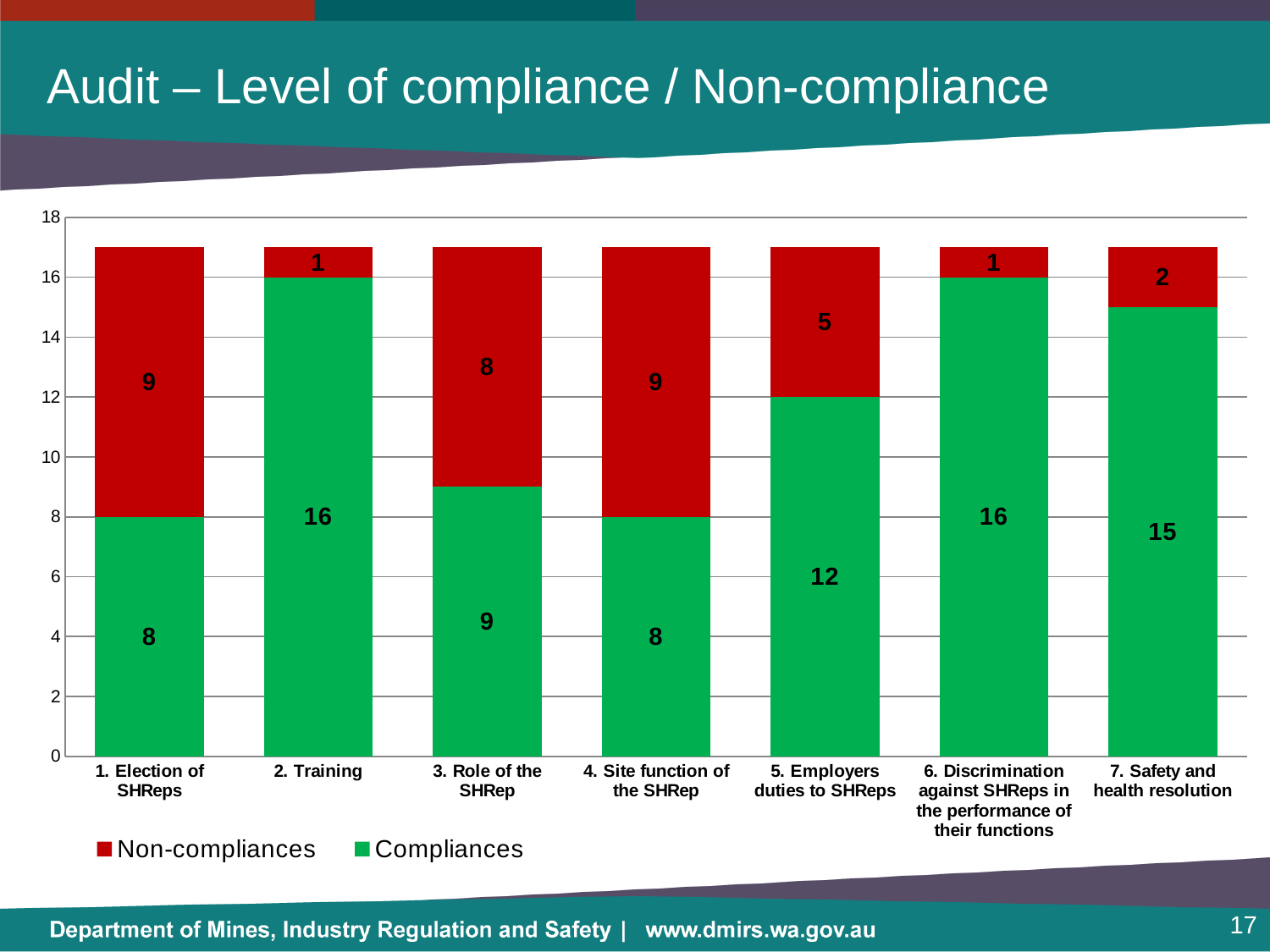
Which category has the lowest number of Compliances? 1. Election of SHReps and 4. Site function of the SHRep (both 8) What is the number of Compliances for 2. Training? 16 What is the difference between Compliances and Non-compliances for 5. Employers duties to SHReps? 7 What is the total of the stacked bar for 1. Election of SHReps? 17 What is the number of Non-compliances for 5. Employers duties to SHReps? 5 What is the number of Non-compliances for 7. Safety and health resolution? 2 What kind of chart is shown on the slide? Stacked bar chart How many categories are shown on the x axis? 7 Which category has the highest number of Non-compliances? 1. Election of SHReps and 4. Site function of the SHRep (both 9) Which is larger for 4. Site function of the SHRep: Compliances or Non-compliances? Non-compliances What is the number of Compliances for 3. Role of the SHRep? 9 How many series does the legend list? 2